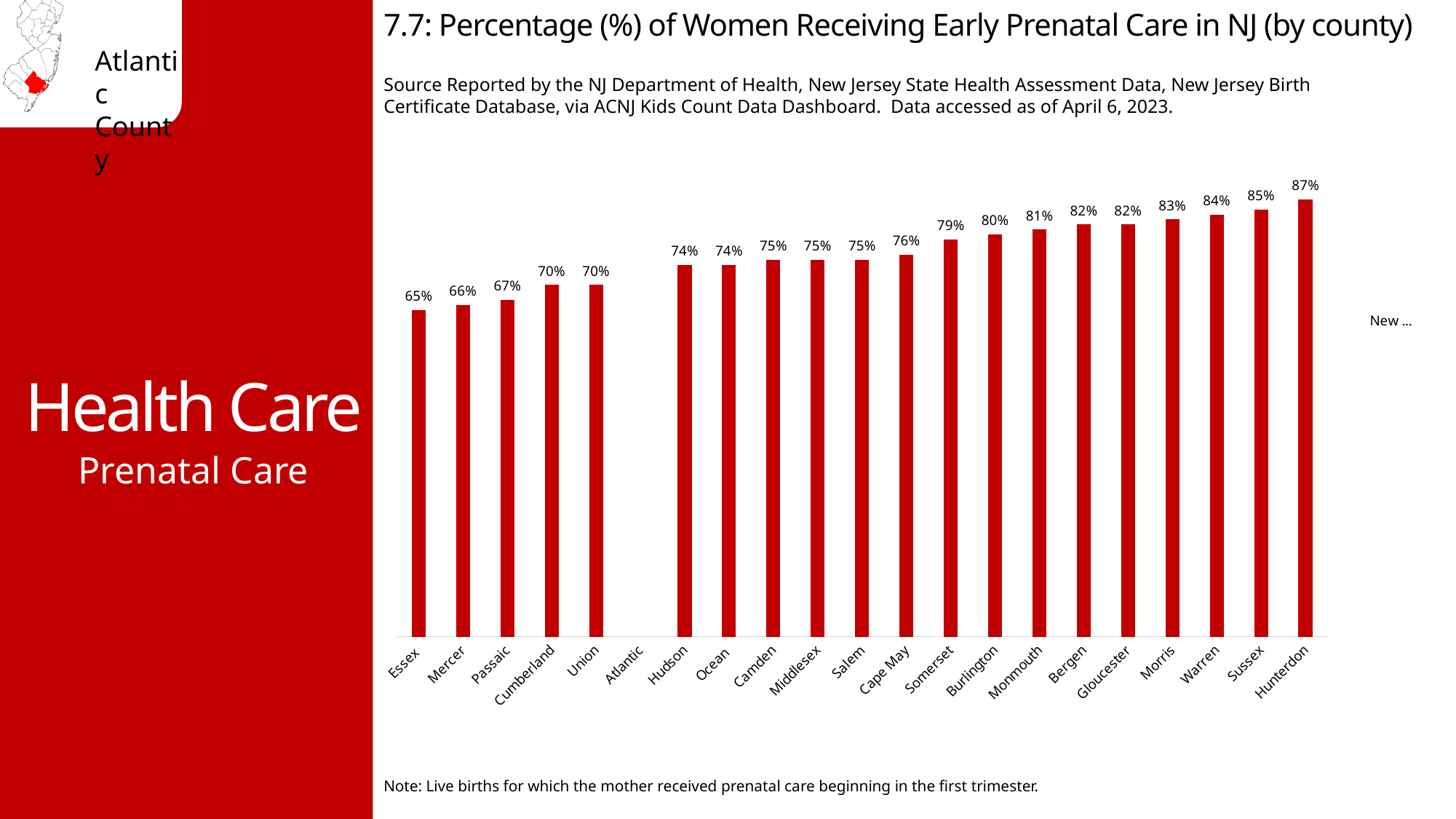
What is the value for Cape May? 76% Which county has the highest percentage of women receiving early prenatal care? Hunterdon How many county labels are shown on the x axis? 21 What is the value for Somerset? 79% Which county with a plotted bar has the lowest percentage? Essex What is the value for Essex? 65% What kind of chart is shown on the slide? Bar chart Do the values generally rise or fall from left to right along the x axis? Rise What is the title of the chart? 7.7: Percentage (%) of Women Receiving Early Prenatal Care in NJ (by county) Which is larger, the value for Morris or the value for Cape May? Morris What is the value for Hunterdon? 87% What is the difference between the values for Hunterdon and Essex? 22 percentage points